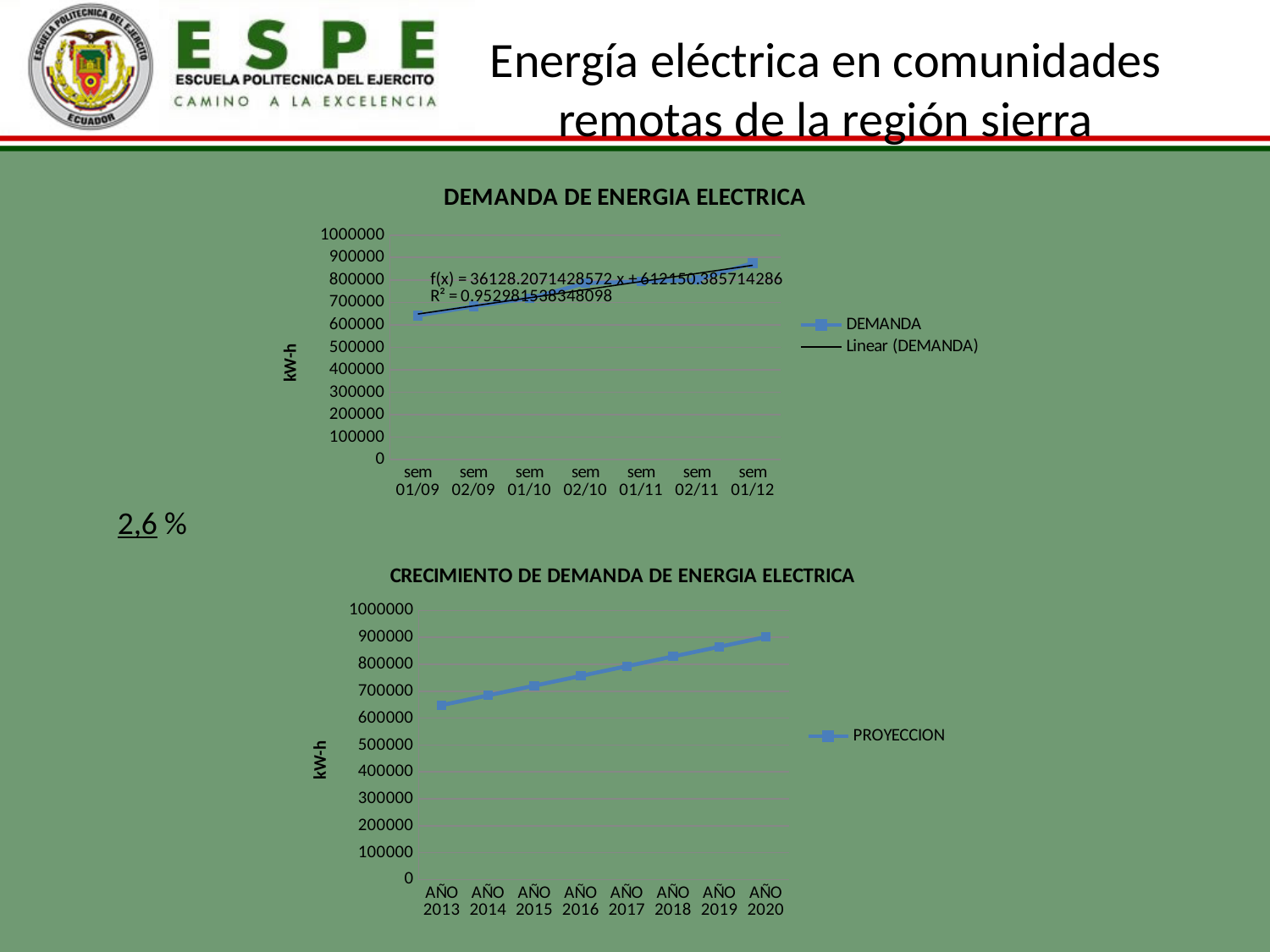
What kind of chart is the 'DEMANDA DE ENERGIA ELECTRICA' chart? Line chart In the 'DEMANDA DE ENERGIA ELECTRICA' chart, is the value for sem 01/09 greater or less than 700000? less In the 'DEMANDA DE ENERGIA ELECTRICA' chart, which period has the lowest demand? sem 01/09 In the 'CRECIMIENTO DE DEMANDA DE ENERGIA ELECTRICA' chart, do the projected values rise or fall from AÑO 2013 to AÑO 2020? Rise In the 'CRECIMIENTO DE DEMANDA DE ENERGIA ELECTRICA' chart, is the value for AÑO 2020 greater or less than 800000? greater How many series does the legend of the 'CRECIMIENTO DE DEMANDA DE ENERGIA ELECTRICA' chart list? 1 What unit is shown on the y-axis of the 'CRECIMIENTO DE DEMANDA DE ENERGIA ELECTRICA' chart? kW-h What kind of chart is the 'CRECIMIENTO DE DEMANDA DE ENERGIA ELECTRICA' chart? Line chart How many entries does the legend of the 'DEMANDA DE ENERGIA ELECTRICA' chart list? 2 In the 'DEMANDA DE ENERGIA ELECTRICA' chart, which period has the highest demand? sem 01/12 In the 'DEMANDA DE ENERGIA ELECTRICA' chart, how many data points are plotted on the DEMANDA series? 7 In the 'CRECIMIENTO DE DEMANDA DE ENERGIA ELECTRICA' chart, how many years are plotted? 8